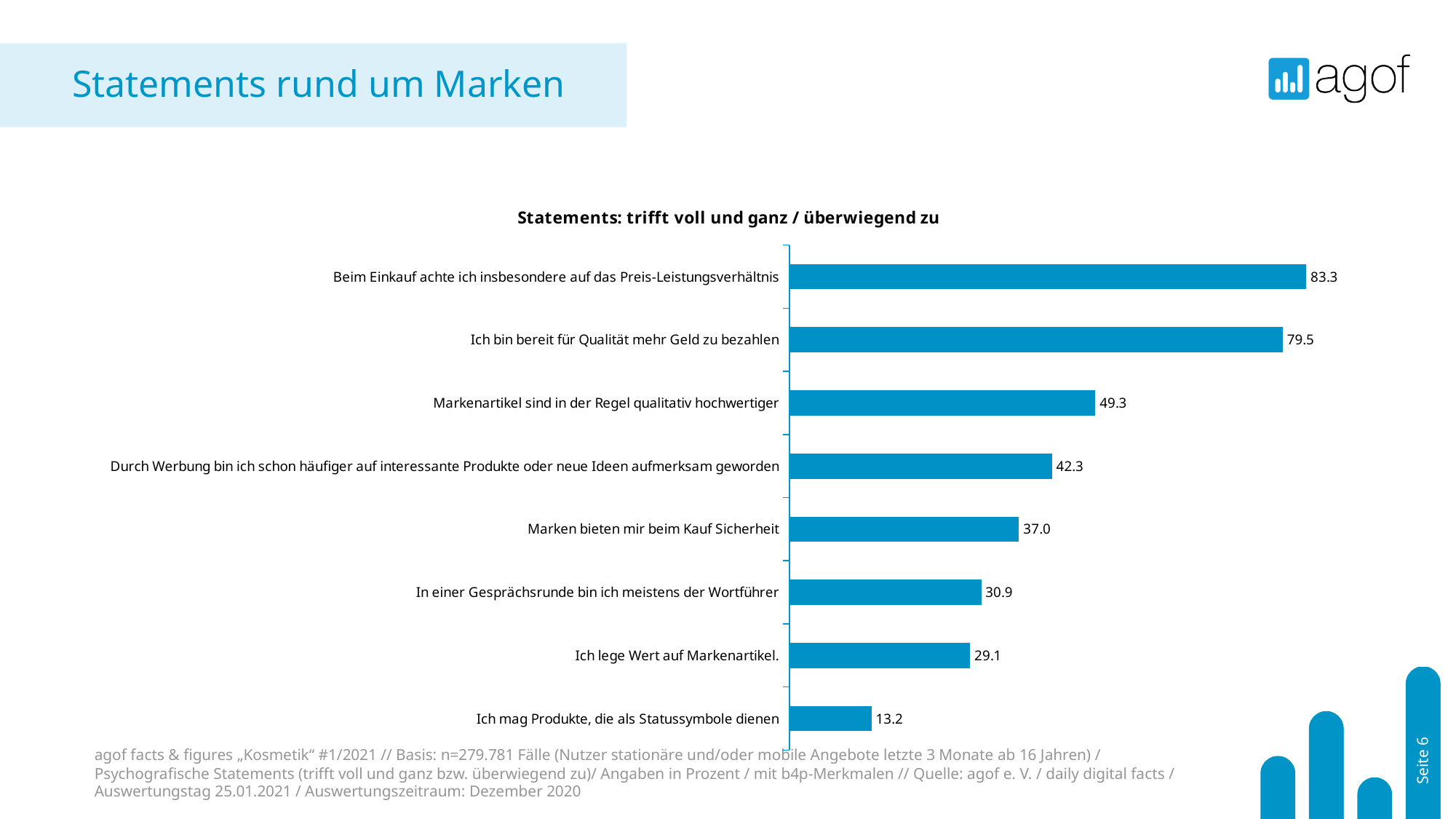
What is the difference between the values for "Beim Einkauf achte ich insbesondere auf das Preis-Leistungsverhältnis" and "Ich bin bereit für Qualität mehr Geld zu bezahlen"? 3.8 Which statement has the highest value? Beim Einkauf achte ich insbesondere auf das Preis-Leistungsverhältnis What is the value for "Ich lege Wert auf Markenartikel."? 29.1 What kind of chart is shown on the slide? Bar chart What is the value for "Ich bin bereit für Qualität mehr Geld zu bezahlen"? 79.5 What is the value for "Marken bieten mir beim Kauf Sicherheit"? 37.0 What is the difference between the values for "Markenartikel sind in der Regel qualitativ hochwertiger" and "Durch Werbung bin ich schon häufiger auf interessante Produkte oder neue Ideen aufmerksam geworden"? 7.0 What colour are the bars in the chart? Blue How many statements are shown in the chart? 8 Which has a larger value: "In einer Gesprächsrunde bin ich meistens der Wortführer" or "Ich lege Wert auf Markenartikel."? In einer Gesprächsrunde bin ich meistens der Wortführer Which statement has the lowest value? Ich mag Produkte, die als Statussymbole dienen What is the title of the chart? Statements: trifft voll und ganz / überwiegend zu